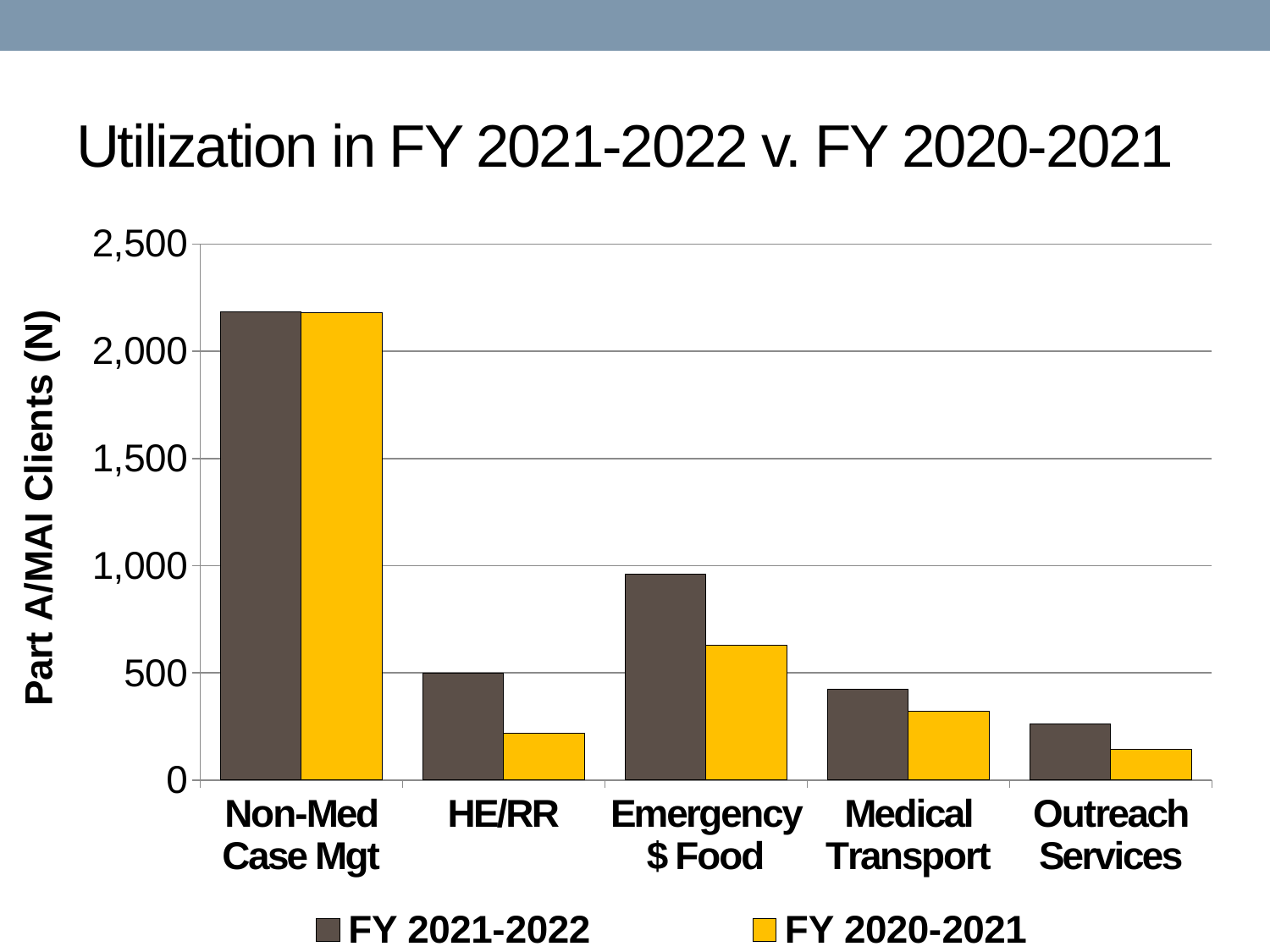
Which category has the lowest value for FY 2020-2021? Outreach Services Which category has the highest value for FY 2021-2022? Non-Med Case Mgt How many service categories are shown on the x axis? 5 Is the FY 2021-2022 value for Emergency $ Food greater or less than 1,000? less How many series does the legend list? 2 Is the FY 2021-2022 value for Non-Med Case Mgt greater or less than 2,000? greater What is the title of the y axis? Part A/MAI Clients (N) Is the FY 2020-2021 value for Emergency $ Food greater or less than 500? greater For Emergency $ Food, which is larger: FY 2021-2022 or FY 2020-2021? FY 2021-2022 What kind of chart is shown on the slide? Bar chart What colour represents FY 2020-2021 in the legend? Yellow